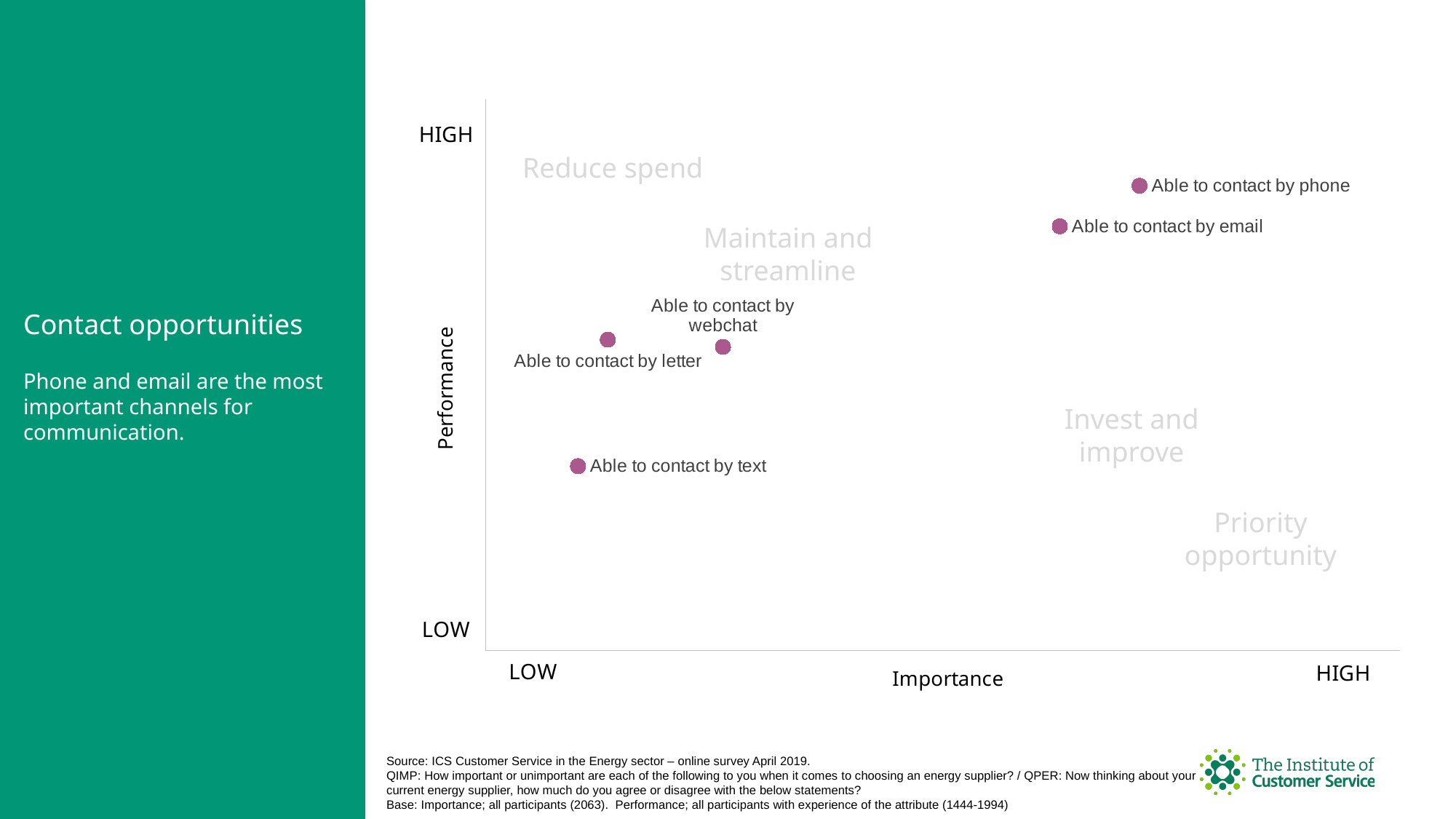
Which has higher performance, 'Able to contact by phone' or 'Able to contact by email'? Able to contact by phone How many data points are plotted on the chart? 5 What is the label of the horizontal axis? Importance Which has higher importance, 'Able to contact by letter' or 'Able to contact by webchat'? Able to contact by webchat Which contact channel has the highest importance? Able to contact by phone What kind of chart is shown on the slide? Scatter chart Which contact channel has the lowest performance? Able to contact by text What is the label of the vertical axis? Performance Which contact channel has the lowest importance? Able to contact by text Which has higher performance, 'Able to contact by text' or 'Able to contact by letter'? Able to contact by letter Which contact channel has the highest performance? Able to contact by phone